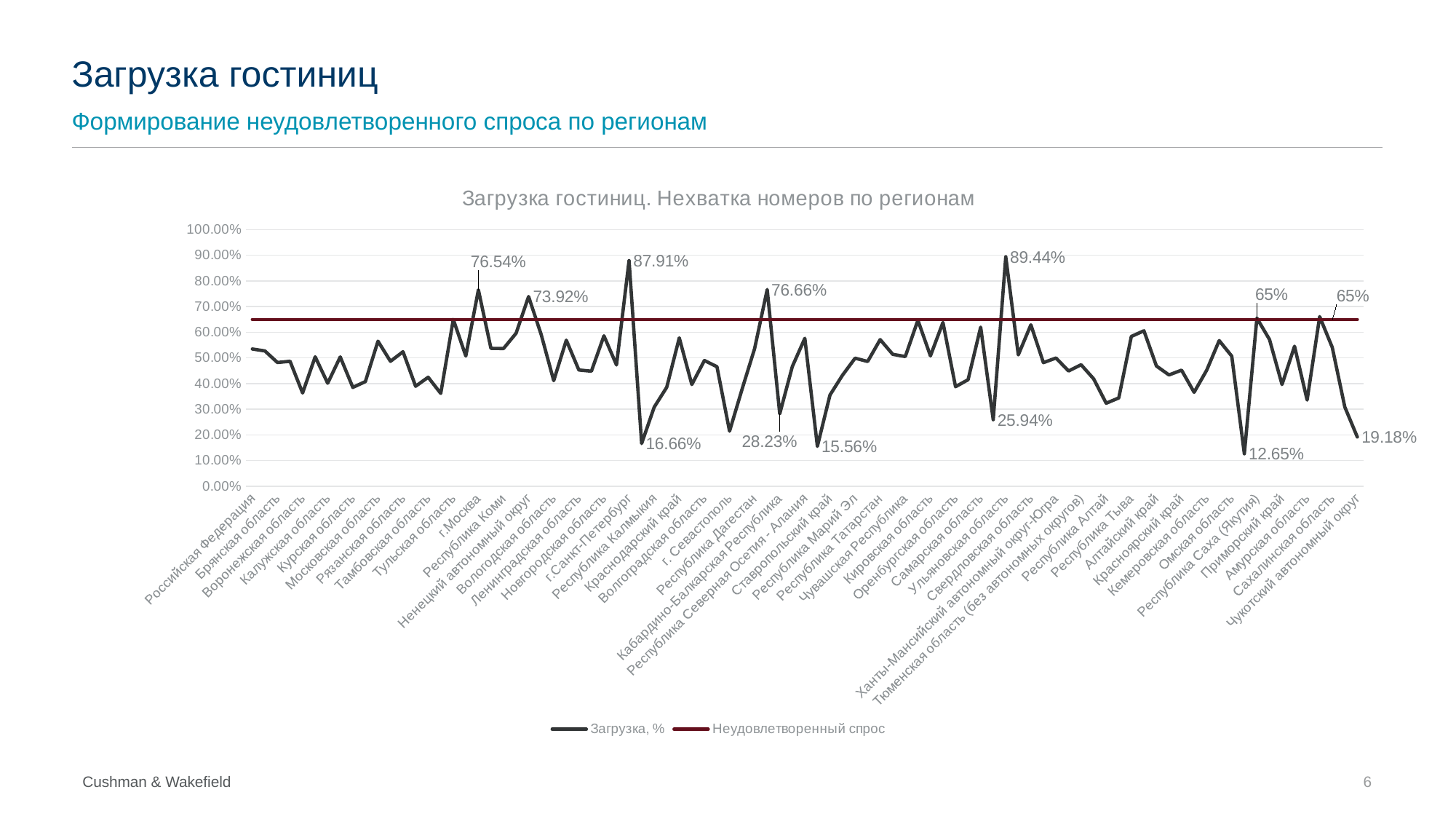
Which has a higher Загрузка, % value: Республика Дагестан or Ненецкий автономный округ? Ненецкий автономный округ Is the Загрузка, % value for Российская Федерация greater or less than 40.00%? greater What is the value of Загрузка, % for г.Санкт-Петербург? 87.91% What kind of chart is shown on the slide? line chart Which region has the highest Загрузка, % value? Ульяновская область What is the value of Загрузка, % for г.Москва? 76.54% How many series does the legend list? 2 At what level is the Неудовлетворенный спрос line drawn? 65%